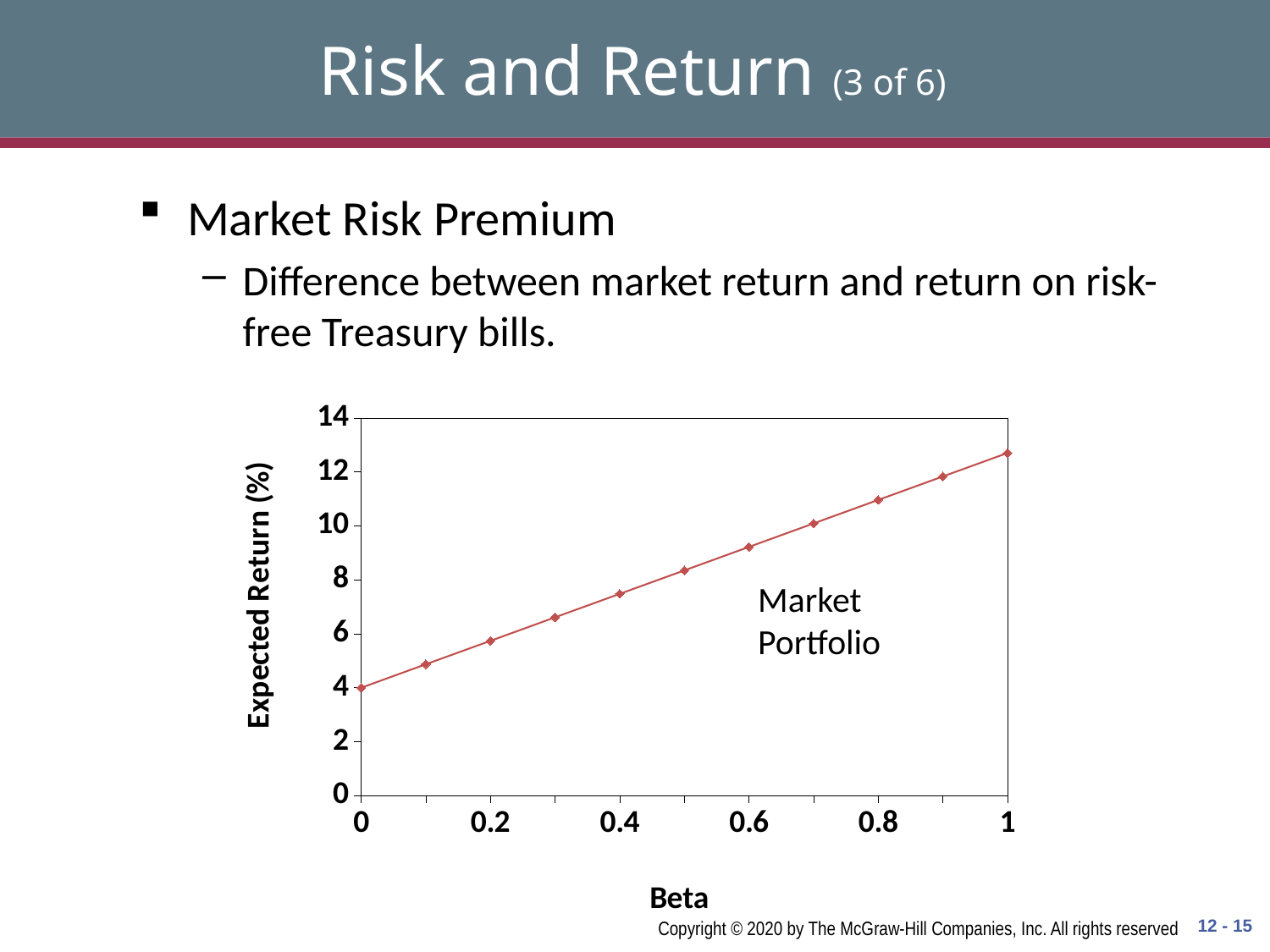
Do the expected return values rise or fall as beta increases along the x axis? rise Is the expected return at a beta of 0.6 greater or less than 10? less What text annotation appears next to the line in the chart? Market Portfolio What kind of chart is shown on the slide? line chart Is the expected return at a beta of 1 greater or less than 12? greater At which beta value is the expected return lowest? 0 How many data points are plotted on the line? 11 Which has a higher expected return, a beta of 0.8 or a beta of 0.2? 0.8 What is the label on the y axis of the chart? Expected Return (%) At which beta value is the expected return highest? 1 Is the expected return at a beta of 0.5 greater or less than 8? greater